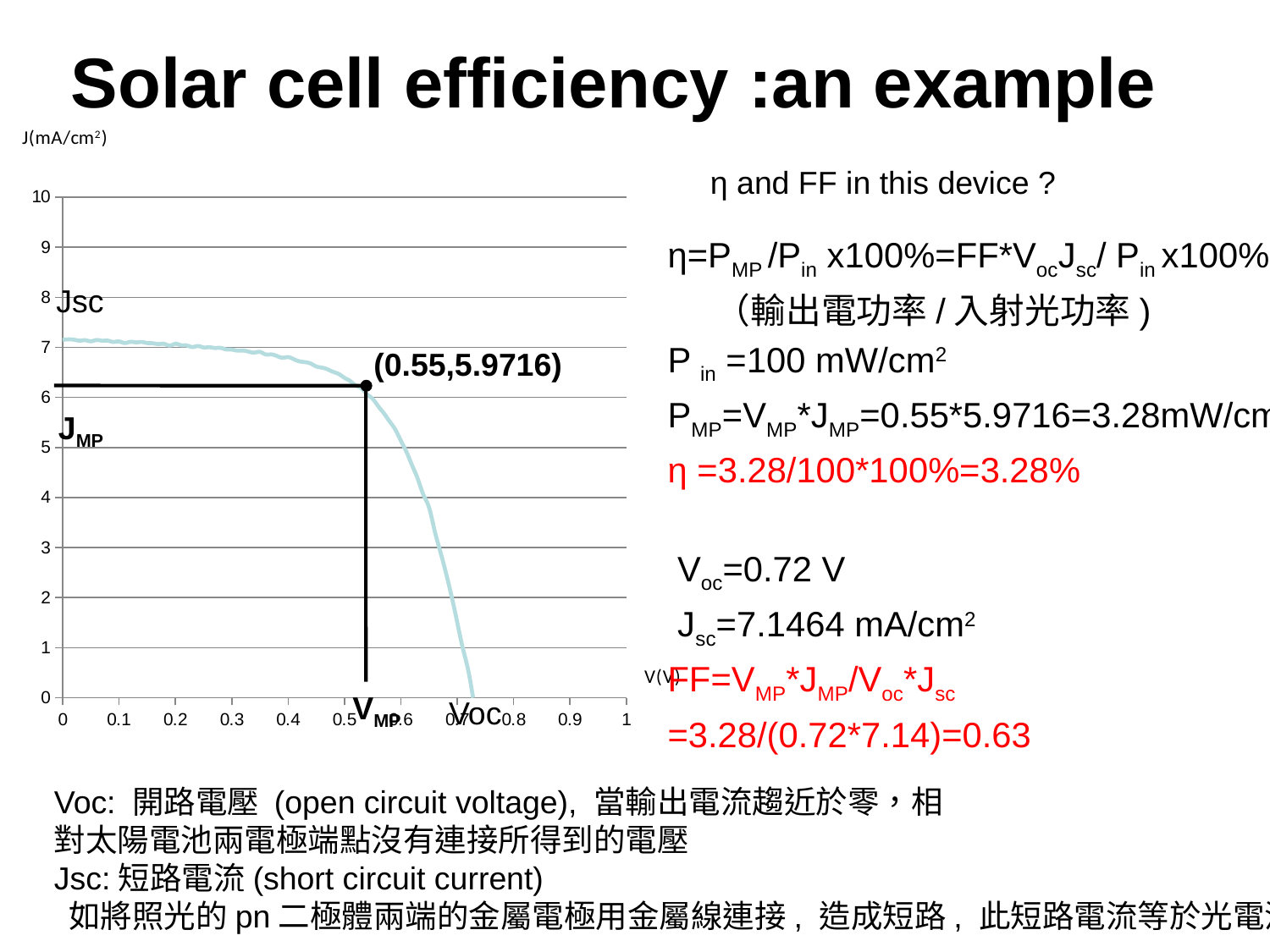
What kind of chart is shown on the slide? line chart What is the voltage at the labelled maximum power point? 0.55 What is the current density J at the labelled maximum power point? 5.9716 How many curves are plotted on the chart? 1 What is the highest tick value shown on the y axis? 10 What are the coordinates of the labelled point on the curve? (0.55,5.9716) Does the curve rise or fall as the voltage increases along the x axis? fall What is the label of the y axis? J(mA/cm2) Is the value of J at V=0.4 greater or less than 5? greater Is the value of J at V=0.7 greater or less than 2? less Is the value of J at V=0.2 greater or less than 6? greater